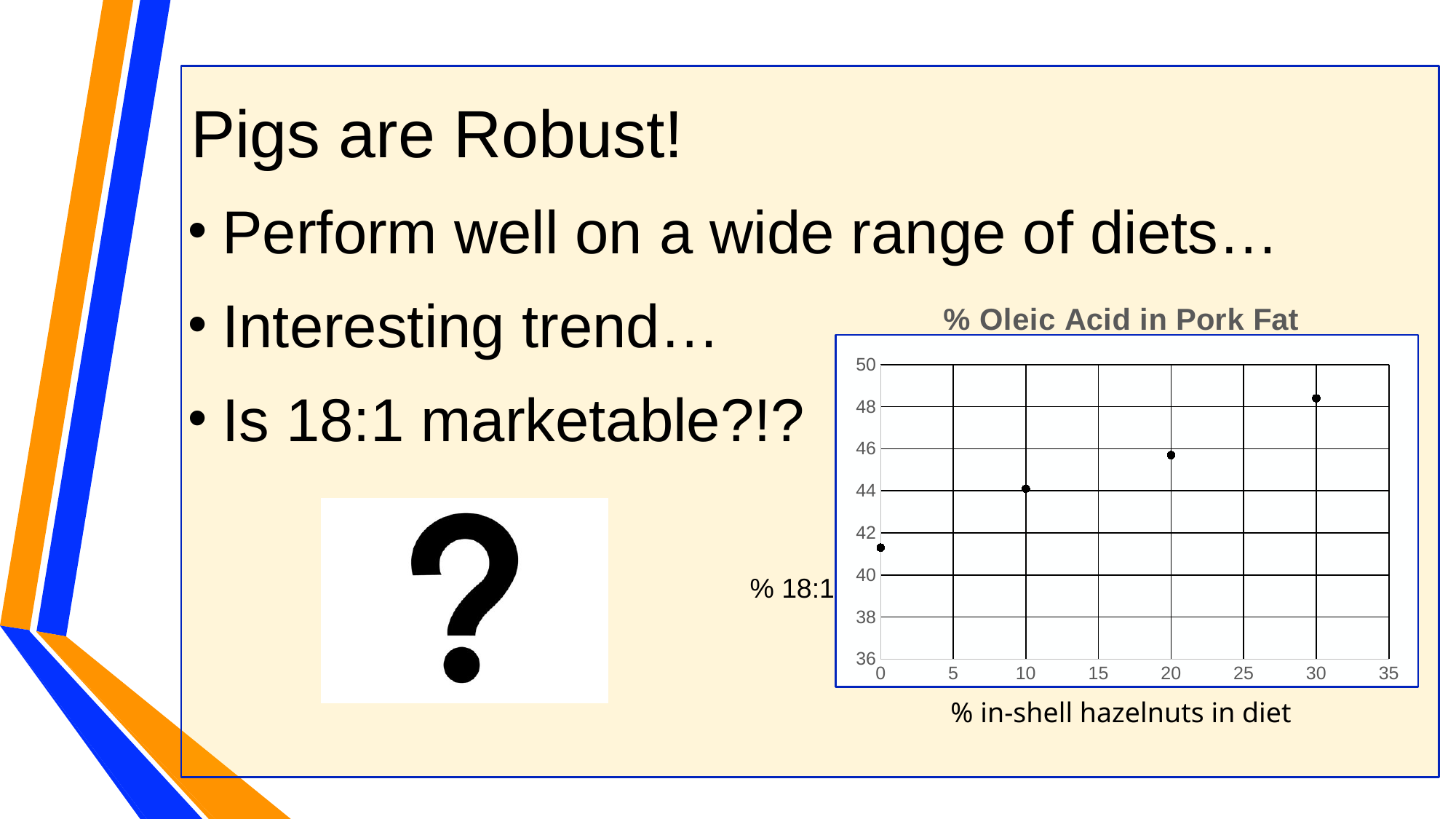
Is the value at 30% in-shell hazelnuts greater or less than 48? greater At which % in-shell hazelnuts in diet is the % oleic acid highest? 30 Is the value at 0% in-shell hazelnuts greater or less than 42? less What kind of chart is shown on the slide? scatter plot Which has the higher % oleic acid: 10% or 20% in-shell hazelnuts in diet? 20 How many data points are plotted on the chart? 4 Do the values rise or fall as the % in-shell hazelnuts in diet increases? rise Is the value at 20% in-shell hazelnuts greater or less than 46? less What is the label on the x axis of the chart? % in-shell hazelnuts in diet What is the title of the chart? % Oleic Acid in Pork Fat At which % in-shell hazelnuts in diet is the % oleic acid lowest? 0